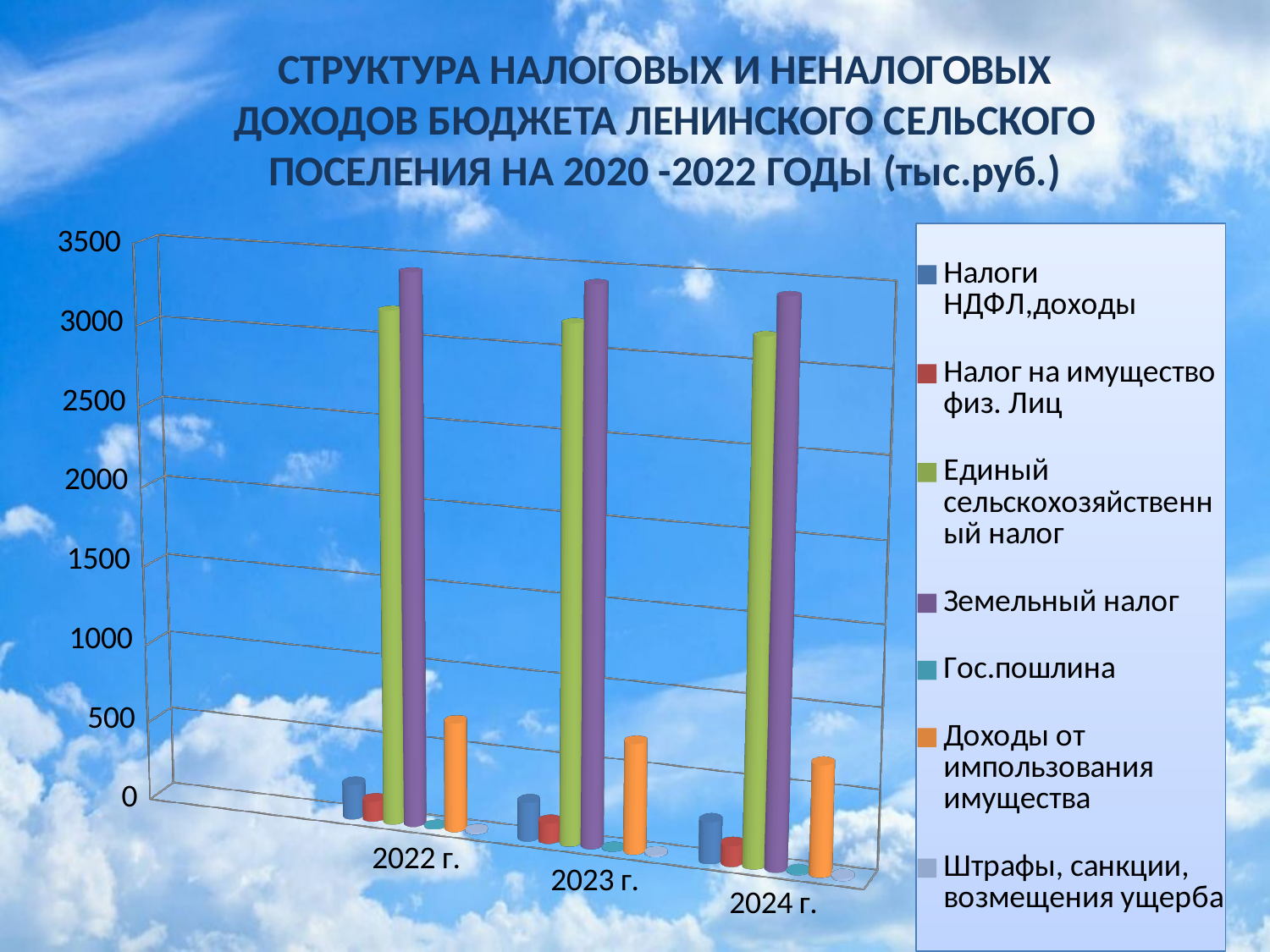
Which series has the highest value in 2022 г.? Земельный налог How many year categories are shown on the x axis? 3 Is the value for Налоги НДФЛ,доходы in 2022 г. greater or less than 500? less Is the value for Земельный налог in 2022 г. greater or less than 3000? greater Which series has the highest value in 2024 г.? Земельный налог In 2022 г., which is larger: Земельный налог or Единый сельскохозяйственный налог? Земельный налог What kind of chart is shown on the slide? bar chart How many series does the legend list? 7 What colour represents Земельный налог in the legend? purple In 2023 г., which is larger: Доходы от импользования имущества or Налог на имущество физ. Лиц? Доходы от импользования имущества